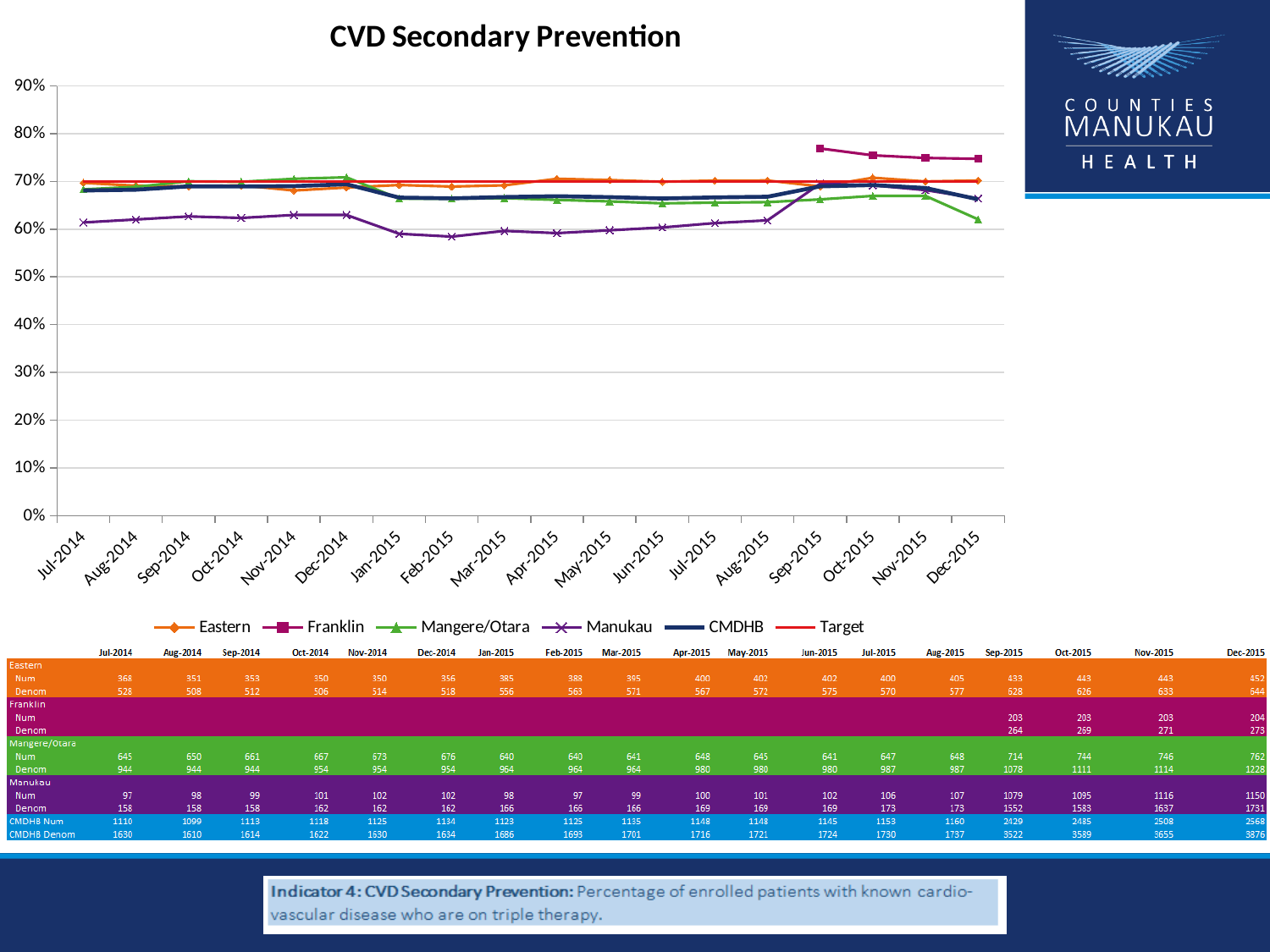
How many series does the chart legend list? 6 Is the value for Franklin in Sep-2015 greater or less than 70%? greater Is the value for Mangere/Otara in Dec-2015 greater or less than 70%? less Is the value for Manukau in Feb-2015 greater or less than 60%? less Which series has the highest value in Oct-2015? Franklin Which series has the lowest value in Feb-2015? Manukau What kind of chart is shown on the slide? line chart How many months are shown along the x axis of the chart? 18 In Jan-2015, which is higher: Eastern or Manukau? Eastern In Sep-2015, which is higher: Franklin or Manukau? Franklin Does the Manukau line rise or fall from Dec-2014 to Jan-2015? fall